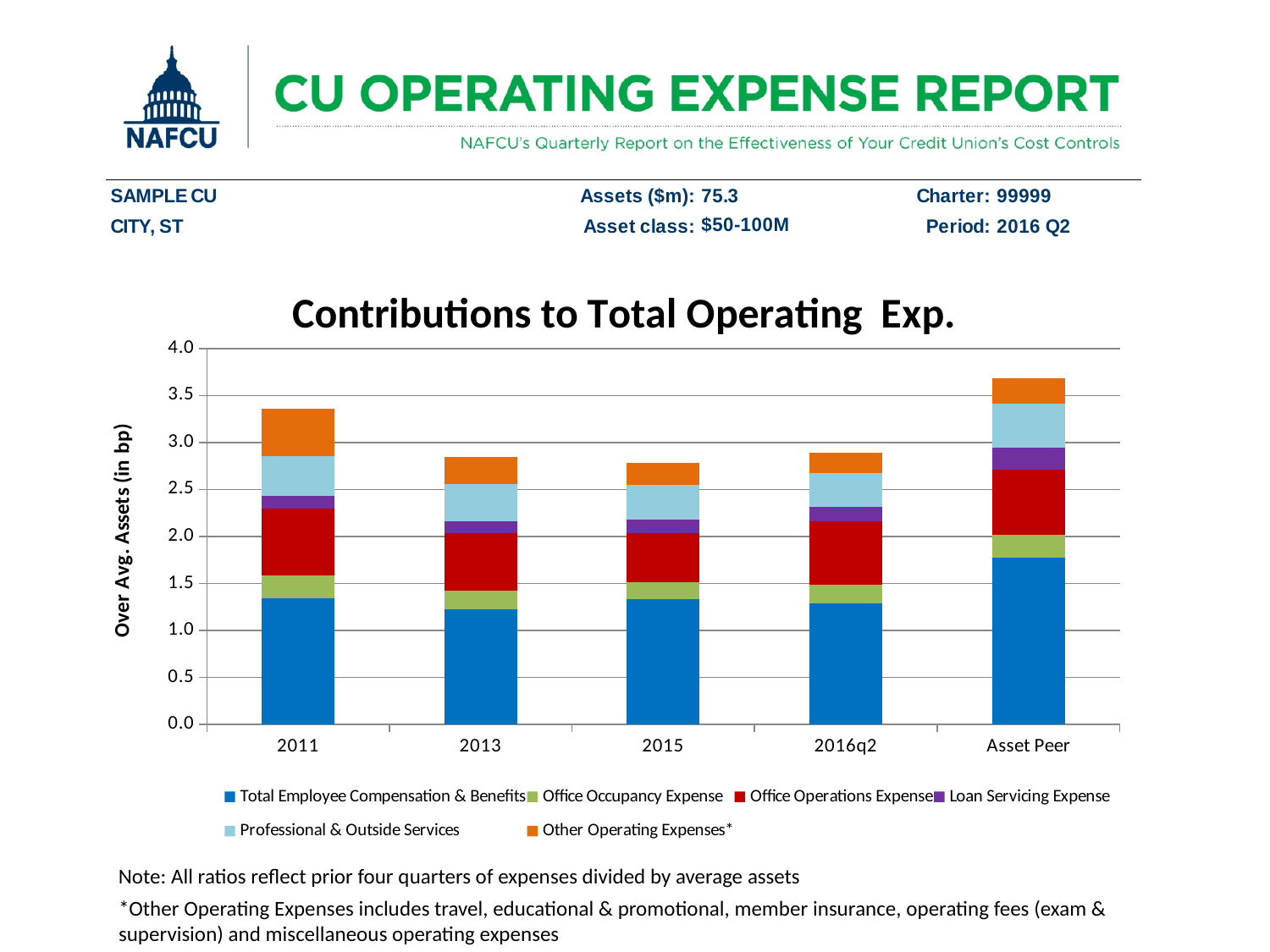
Is the Total Employee Compensation & Benefits segment for 2011 greater or less than 1.5? less Is the Total Employee Compensation & Benefits segment for Asset Peer greater or less than 1.5? greater Is the total stacked bar for Asset Peer greater or less than 3.5? greater What is the title of the chart? Contributions to Total Operating Exp. What kind of chart is shown on the slide? Stacked bar chart How many series does the chart's legend list? 6 What is the label on the chart's y axis? Over Avg. Assets (in bp) Which has the larger total stacked bar, 2011 or 2013? 2011 Which category has the highest total stacked bar? Asset Peer How many categories are shown along the x axis of the chart? 5